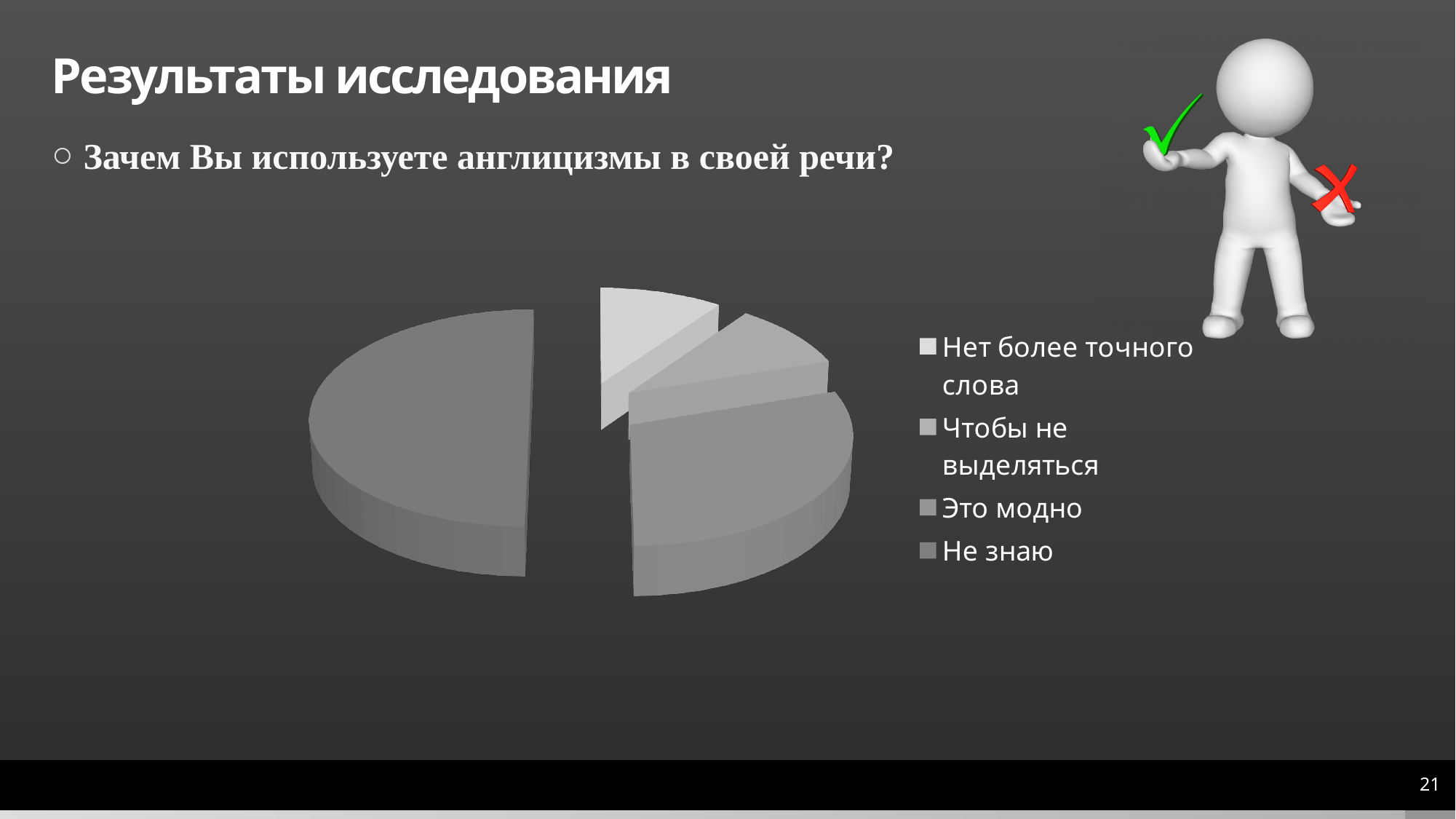
How many entries does the chart legend list? 4 How many slices does the pie chart have? 4 Which slice is larger: "Это модно" or "Нет более точного слова"? Это модно Which category has the largest slice in the pie chart? Не знаю What question do the pie chart results answer, according to the slide? Зачем Вы используете англицизмы в своей речи? What kind of chart is shown on the slide? pie chart Which slice is larger: "Не знаю" or "Это модно"? Не знаю Which slice is larger: "Не знаю" or "Чтобы не выделяться"? Не знаю